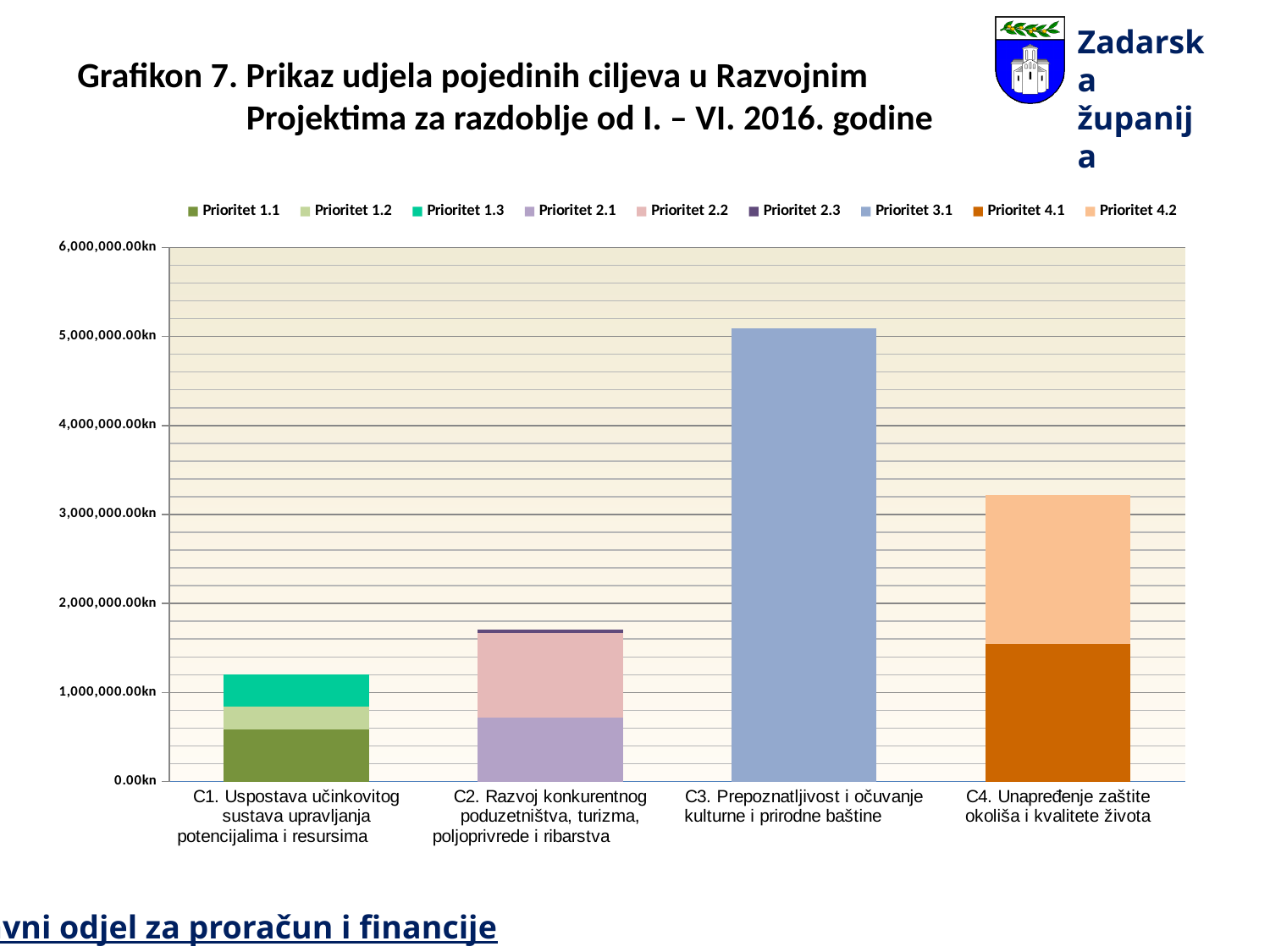
Which series is listed first in the legend? Prioritet 1.1 Is the total value for C1 greater or less than 2,000,000.00kn? less What period does the chart title say the data covers? I. – VI. 2016. godine Is the total value for C3 greater or less than 4,000,000.00kn? greater How many categories (ciljevi) are shown on the x axis? 4 Which category has the tallest stacked bar? C3. Prepoznatljivost i očuvanje kulturne i prirodne baštine How many series does the legend list? 9 Is the total value for C4 greater or less than 3,000,000.00kn? greater Which category has the shortest stacked bar? C1. Uspostava učinkovitog sustava upravljanja potencijalima i resursima Which stacked bar is taller: C4 or C2? C4 What kind of chart is shown on the slide? stacked bar chart